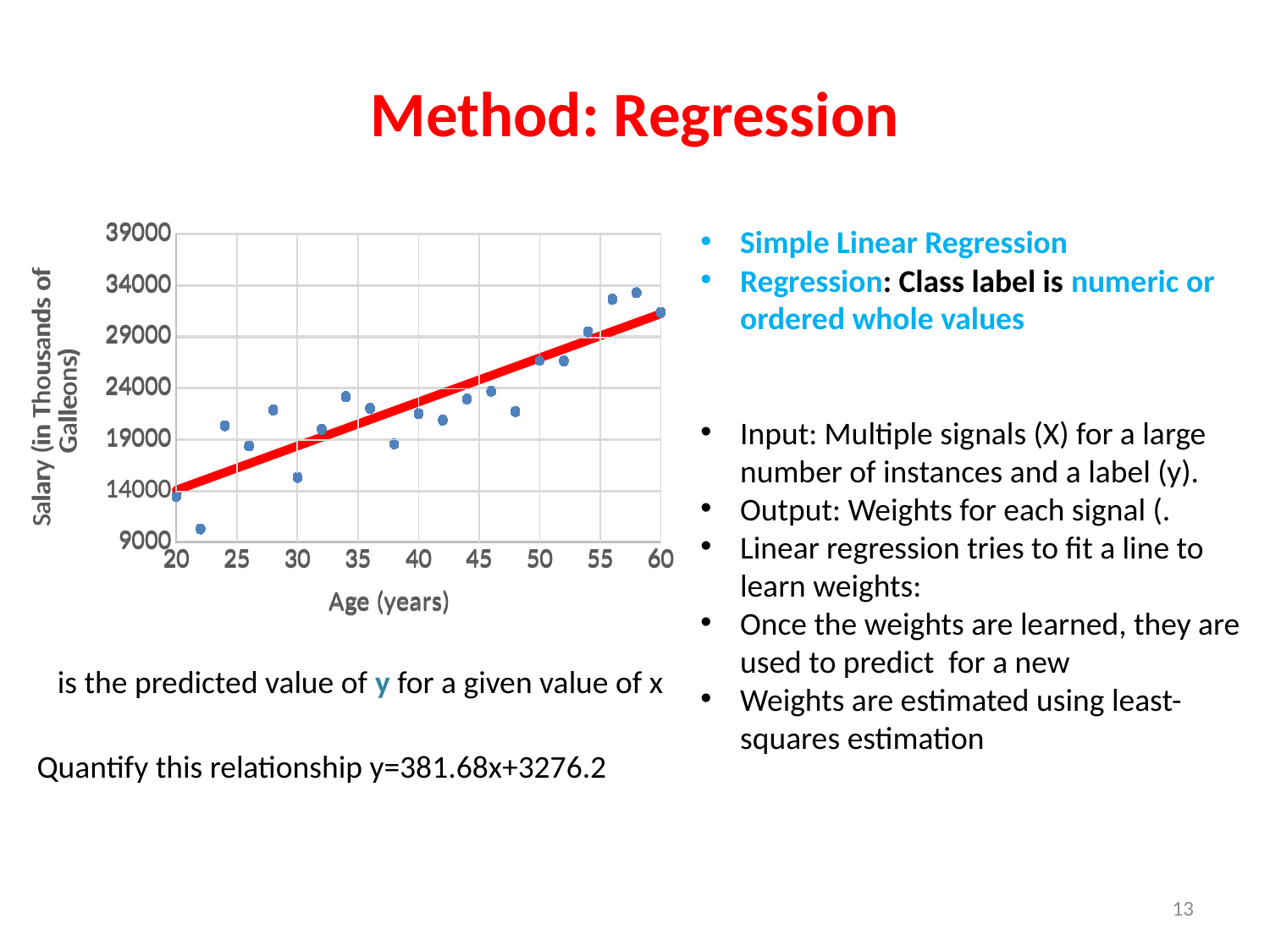
Is the salary value for age 56 greater or less than 29000? greater Is the salary value for age 22 greater or less than 14000? less Do salary values generally rise or fall as age increases along the x axis? Rise Is the salary value for age 50 greater or less than 24000? greater What regression equation is given on the slide for the relationship in the chart? y=381.68x+3276.2 How many data points are plotted in the scatter chart? 21 What kind of chart is shown on the slide? Scatter plot At which age is the lowest salary point plotted? 22 What is the label of the y axis of the chart? Salary (in Thousands of Galleons) Which has the higher plotted salary: age 24 or age 30? Age 24 What is the label of the x axis of the chart? Age (years)